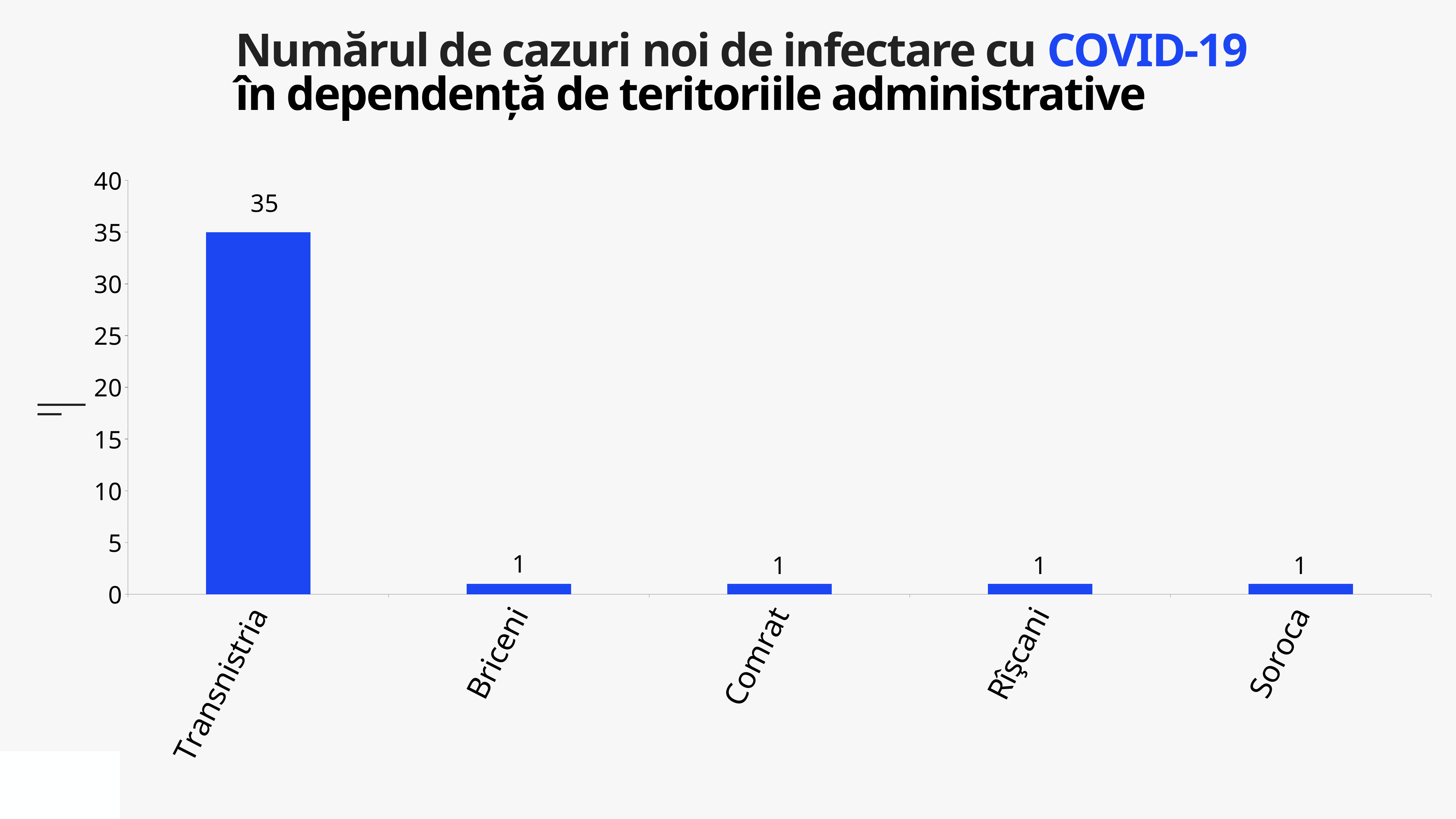
What is the number of new COVID-19 cases for Transnistria? 35 Is the value for Transnistria greater or less than 30? greater What is the number of new COVID-19 cases for Soroca? 1 What is the number of new COVID-19 cases for Briceni? 1 Is the value for Comrat greater or less than 5? less What is the difference between the values for Transnistria and Comrat? 34 What kind of chart is shown on the slide? bar chart How many territories are shown on the chart? 5 Which territory has the highest number of new cases? Transnistria What is the highest value shown on the vertical axis? 40 Which has a larger value, Transnistria or Rîşcani? Transnistria What is the total of all values shown on the chart? 39